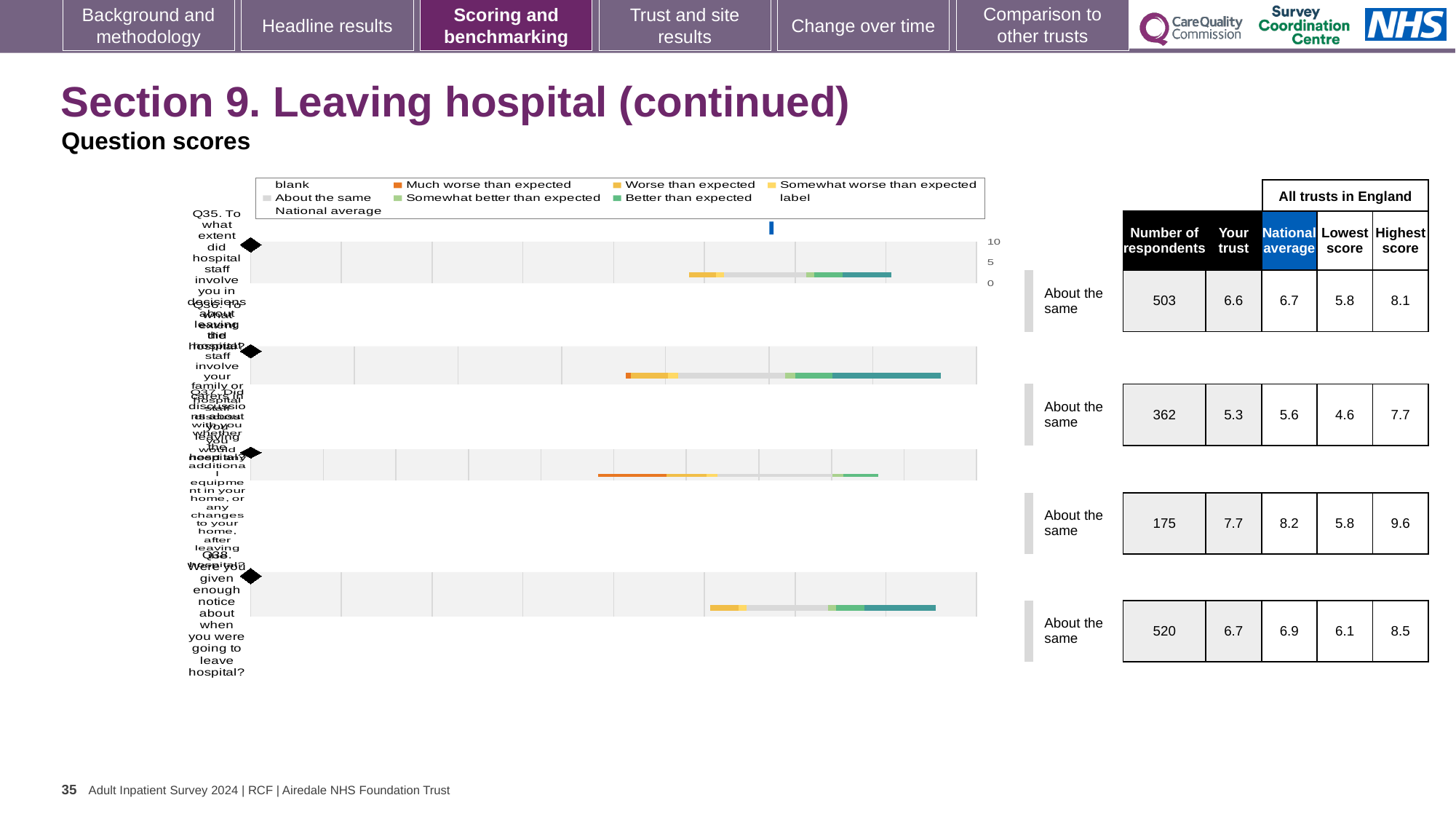
Which question has the lowest 'Your trust' score in the table beside the chart? Q36 What kind of chart is used to show the question scores on this slide? bar chart What is the highest score across all trusts in England for Q37? 9.6 In the table beside the chart, what is the 'Your trust' score for Q38 (given enough notice about when you were going to leave hospital)? 6.7 What benchmark category is shown next to each of the four question bars? About the same Which question has the highest number of respondents in the table beside the chart? Q38 What is the difference between the national average and the 'Your trust' score for Q35? 0.1 In the table beside the chart, what is the national average for Q38? 6.9 For Q38, which is larger: the 'Your trust' score or the national average? National average Which question has the highest 'Your trust' score in the table beside the chart? Q37 How many questions (bars) are plotted in the question scores chart? 4 In the table beside the chart, what is the 'Your trust' score for Q35 (involving you in decisions about leaving hospital)? 6.6